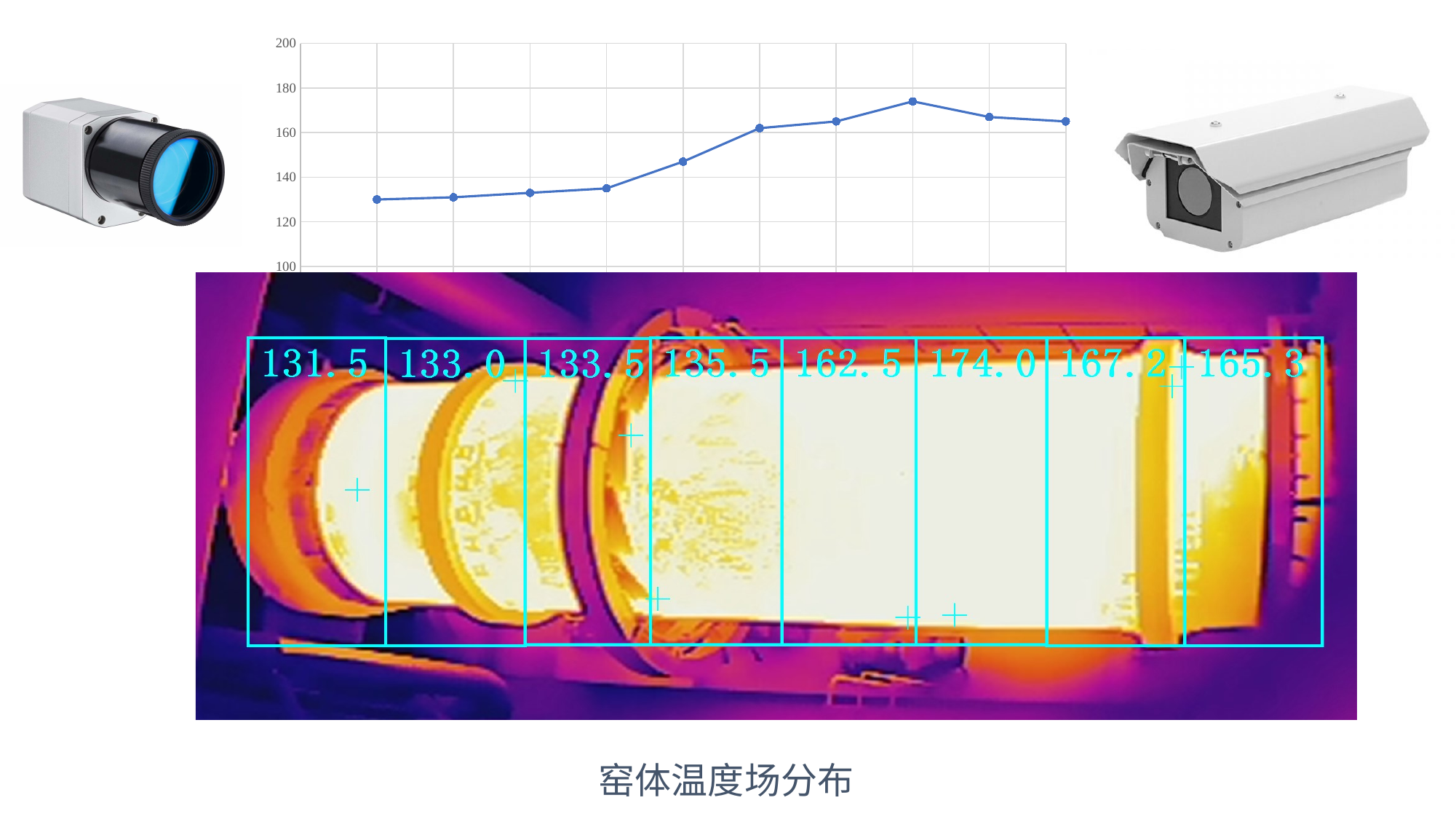
How many series are plotted on the line chart? 1 Is the value of the fifth point on the line chart greater or less than 140? greater What kind of chart is shown at the top of the slide? line chart Which is larger on the line chart, the first point or the last point? the last point Is the value of the last point on the line chart greater or less than 160? greater Is the highest point on the line chart greater or less than 180? less What is the maximum value shown on the vertical axis of the line chart? 200 How many data points are plotted on the line chart? 10 Do the values on the line chart generally rise or fall from left to right? rise